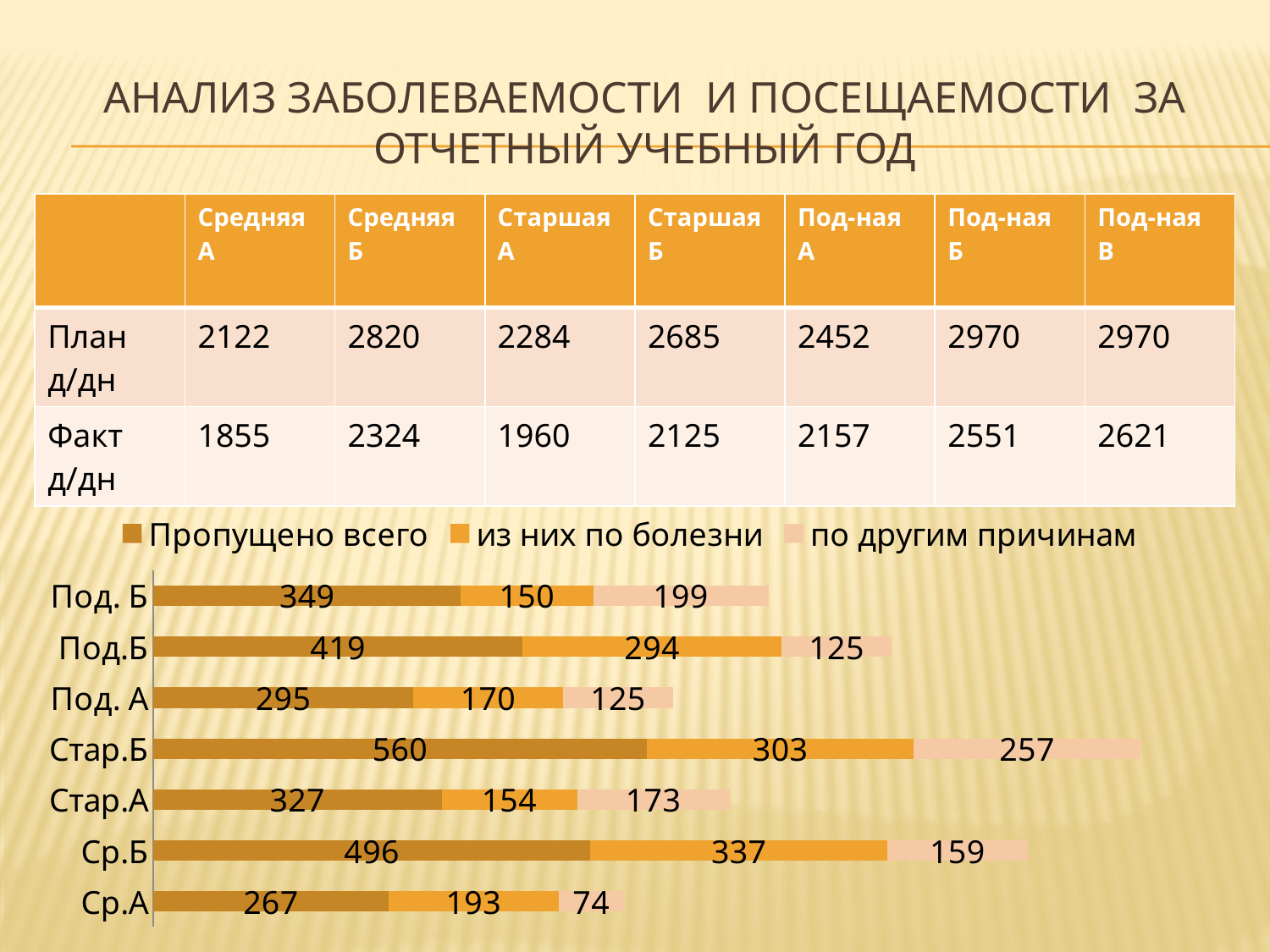
What type of chart is shown on the slide? bar chart Which category has the lowest value for 'по другим причинам'? Ср.А What is the value of 'Пропущено всего' for Стар.Б? 560 Which category has the highest value for 'Пропущено всего'? Стар.Б Which category has the highest value for 'из них по болезни'? Ср.Б How many series does the chart legend list? 3 What is the value of 'по другим причинам' for Стар.А? 173 What is the difference between the 'Пропущено всего' values for Ср.Б and Ср.А? 229 Which is larger: 'из них по болезни' for Стар.Б or for Стар.А? Стар.Б What is the value of 'из них по болезни' for Ср.А? 193 What is the total of the three segments in the Ср.А bar? 534 How many categories (bars) are shown in the chart? 7